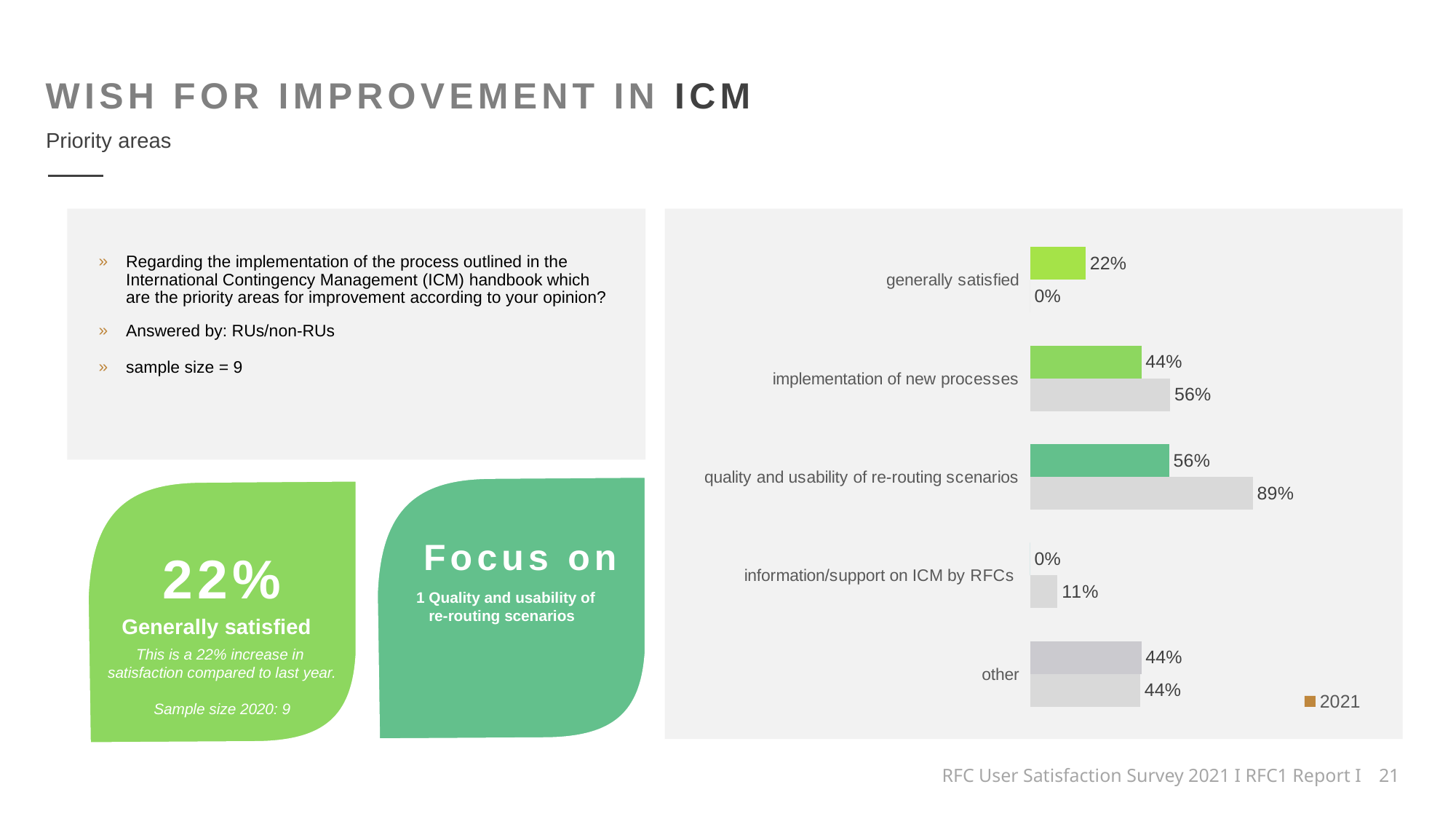
How many series does the chart's legend list? 1 What kind of chart is shown on the right side of the slide? bar chart Which category has the highest value among the upper (coloured) bars? quality and usability of re-routing scenarios How many categories are shown on the bar chart? 5 What is the value of the lower (grey) bar for 'quality and usability of re-routing scenarios'? 89% What is the value of the upper bar for 'other'? 44% What is the value of the lower (grey) bar for 'information/support on ICM by RFCs'? 11% What is the difference between the lower (grey) bar and the upper (coloured) bar for 'quality and usability of re-routing scenarios'? 33 percentage points What is the value of the upper (coloured) bar for 'generally satisfied'? 22% What is the value of the upper (coloured) bar for 'quality and usability of re-routing scenarios'? 56% For 'implementation of new processes', which is larger: the upper (coloured) bar or the lower (grey) bar? the lower (grey) bar What entry does the chart's legend show? 2021